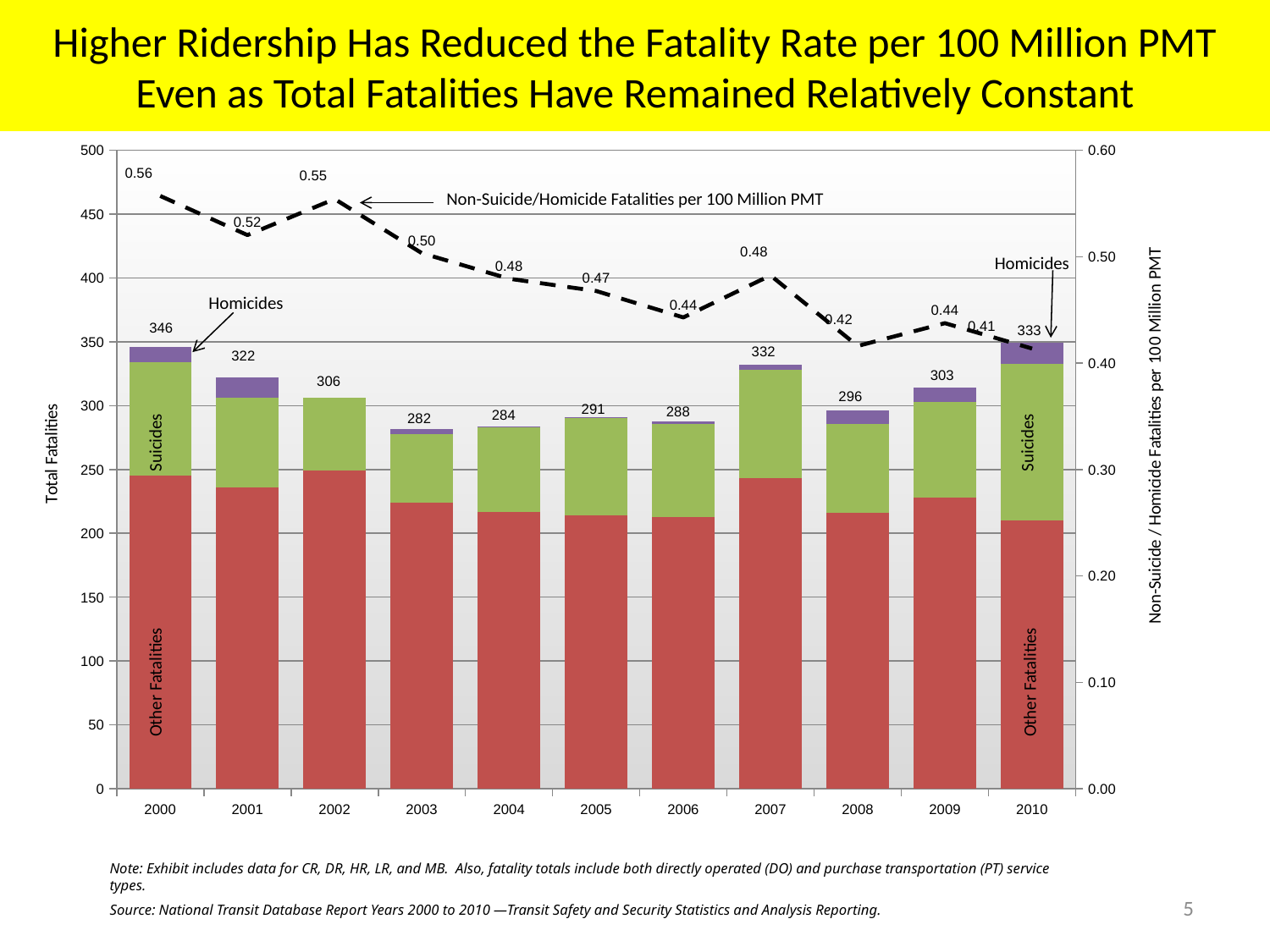
Which year has the lowest total fatalities? 2003 Which year has higher total fatalities, 2008 or 2009? 2009 What is the difference between the fatality rate per 100 Million PMT in 2000 and in 2010? 0.15 What is the Non-Suicide/Homicide Fatalities per 100 Million PMT value for 2003? 0.50 What kind of chart is used to show total fatalities? stacked bar chart Which year has the highest total fatalities? 2000 Does the Non-Suicide/Homicide Fatalities per 100 Million PMT line generally rise or fall from 2000 to 2010? fall How many years are shown on the x axis? 11 Is the Other Fatalities value for 2000 greater or less than 200? greater What is the difference between total fatalities in 2000 and 2003? 64 What is the total fatalities value for 2007? 332 Which year has the lowest Non-Suicide/Homicide Fatalities per 100 Million PMT? 2010